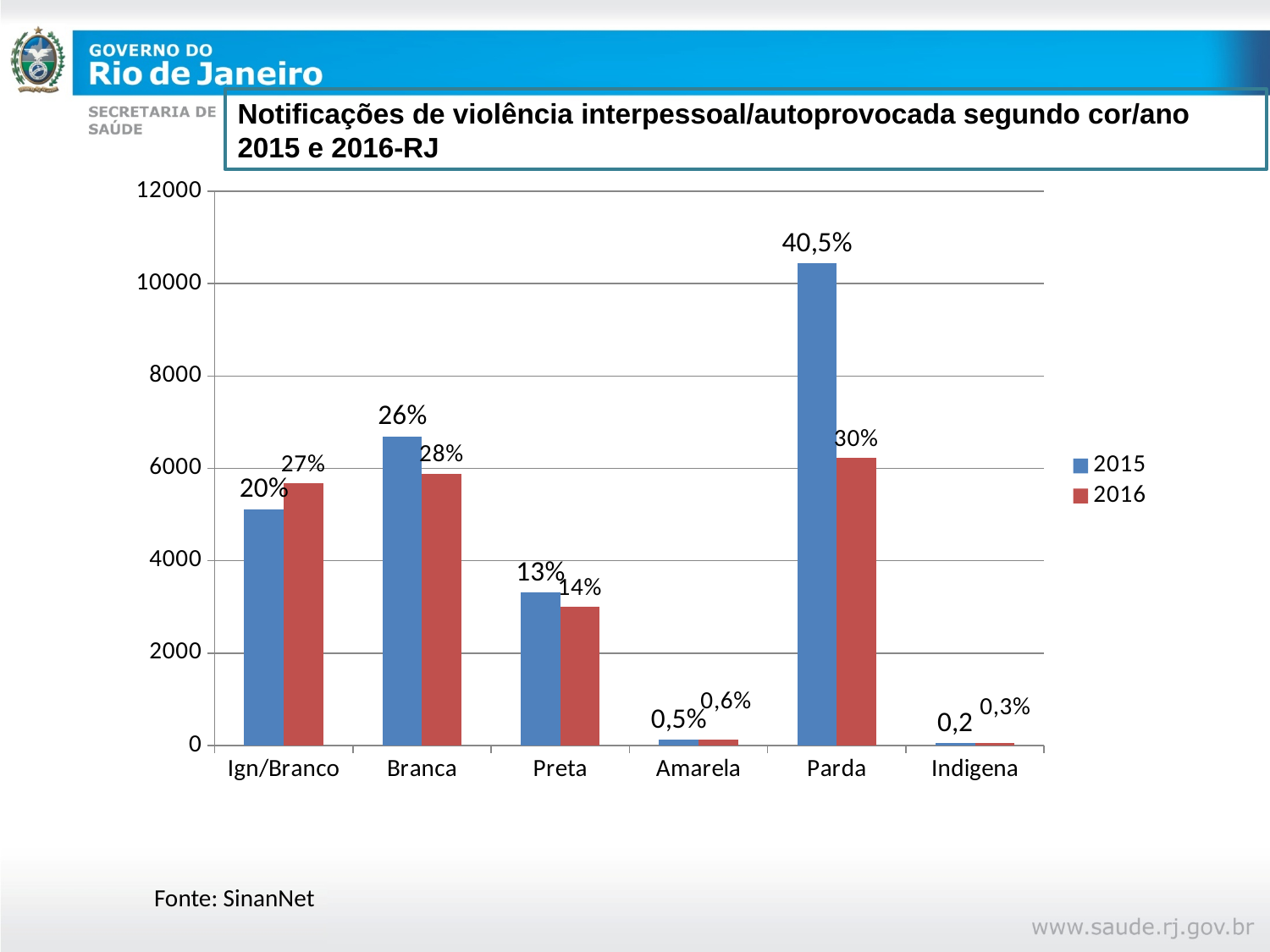
Which category has the lowest bars in the chart? Indigena Is the 2015 bar for Parda greater or less than 10000? greater For Ign/Branco, which year has the taller bar, 2015 or 2016? 2016 For Branca, which year has the taller bar, 2015 or 2016? 2015 What data label is shown on the 2015 bar for Parda? 40,5% What data label is shown on the 2015 bar for Preta? 13% What data label is shown on the 2016 bar for Branca? 28% What data label is shown on the 2016 bar for Amarela? 0,6% How many series does the legend list? 2 How many categories are shown on the x axis? 6 Which category has the tallest bar in the chart? Parda Is the 2016 bar for Preta greater or less than 4000? less